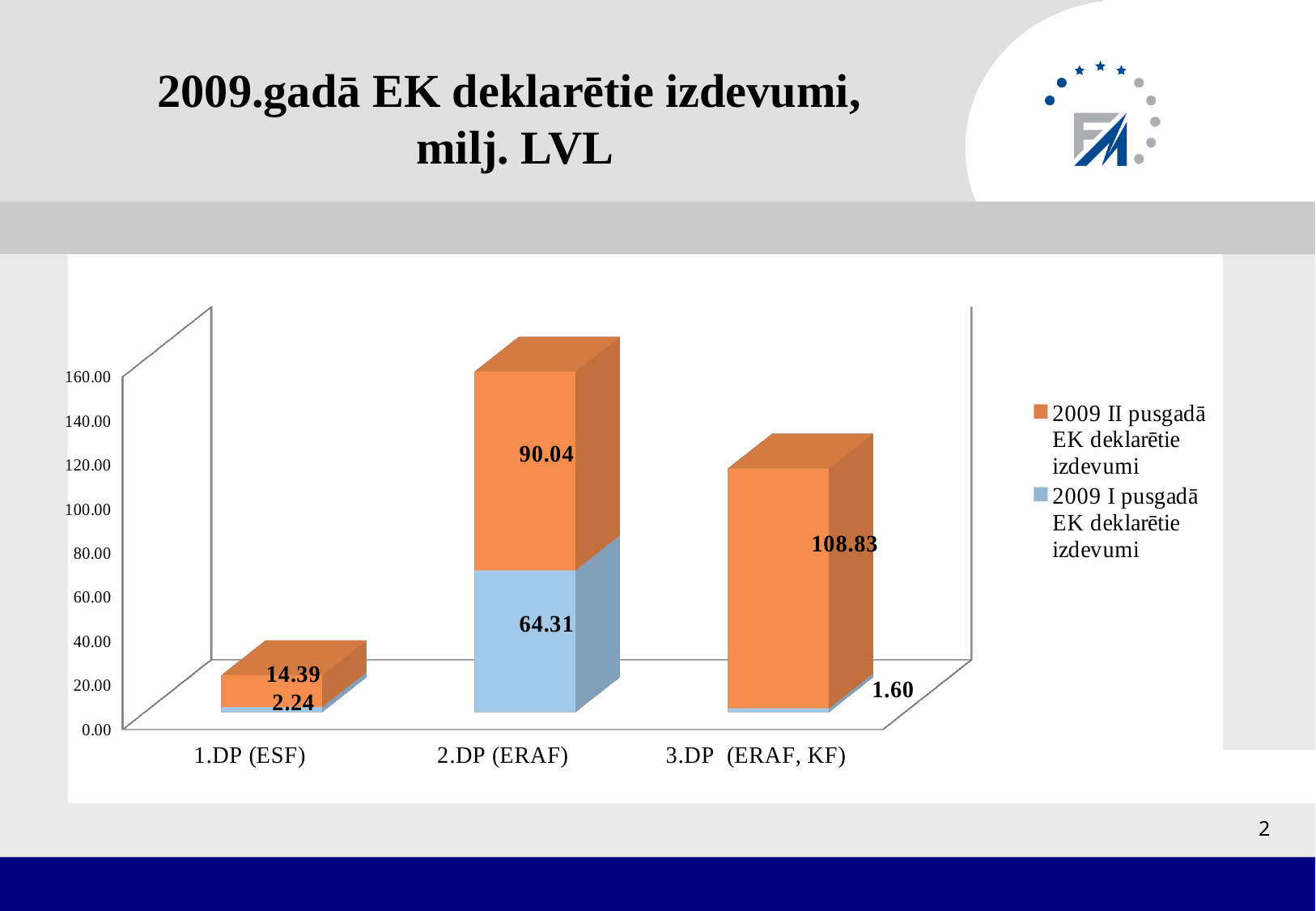
What is the value for 2.DP (ERAF) in the series "2009 II pusgadā EK deklarētie izdevumi"? 90.04 What is the value for 3.DP (ERAF, KF) in the series "2009 I pusgadā EK deklarētie izdevumi"? 1.60 What is the total of the stacked bar for 2.DP (ERAF)? 154.35 How many series does the legend list? 2 How many categories are shown on the x axis? 3 What is the value for 2.DP (ERAF) in the series "2009 I pusgadā EK deklarētie izdevumi"? 64.31 What is the value for 1.DP (ESF) in the series "2009 II pusgadā EK deklarētie izdevumi"? 14.39 What is the difference between the "2009 II pusgadā" value and the "2009 I pusgadā" value for 2.DP (ERAF)? 25.73 Which category has the highest value in the series "2009 II pusgadā EK deklarētie izdevumi"? 3.DP (ERAF, KF) Which category has the lowest value in the series "2009 I pusgadā EK deklarētie izdevumi"? 3.DP (ERAF, KF) Which is larger: the "2009 II pusgadā" value for 3.DP (ERAF, KF) or the "2009 II pusgadā" value for 2.DP (ERAF)? 3.DP (ERAF, KF) What is the total of the stacked bar for 1.DP (ESF)? 16.63